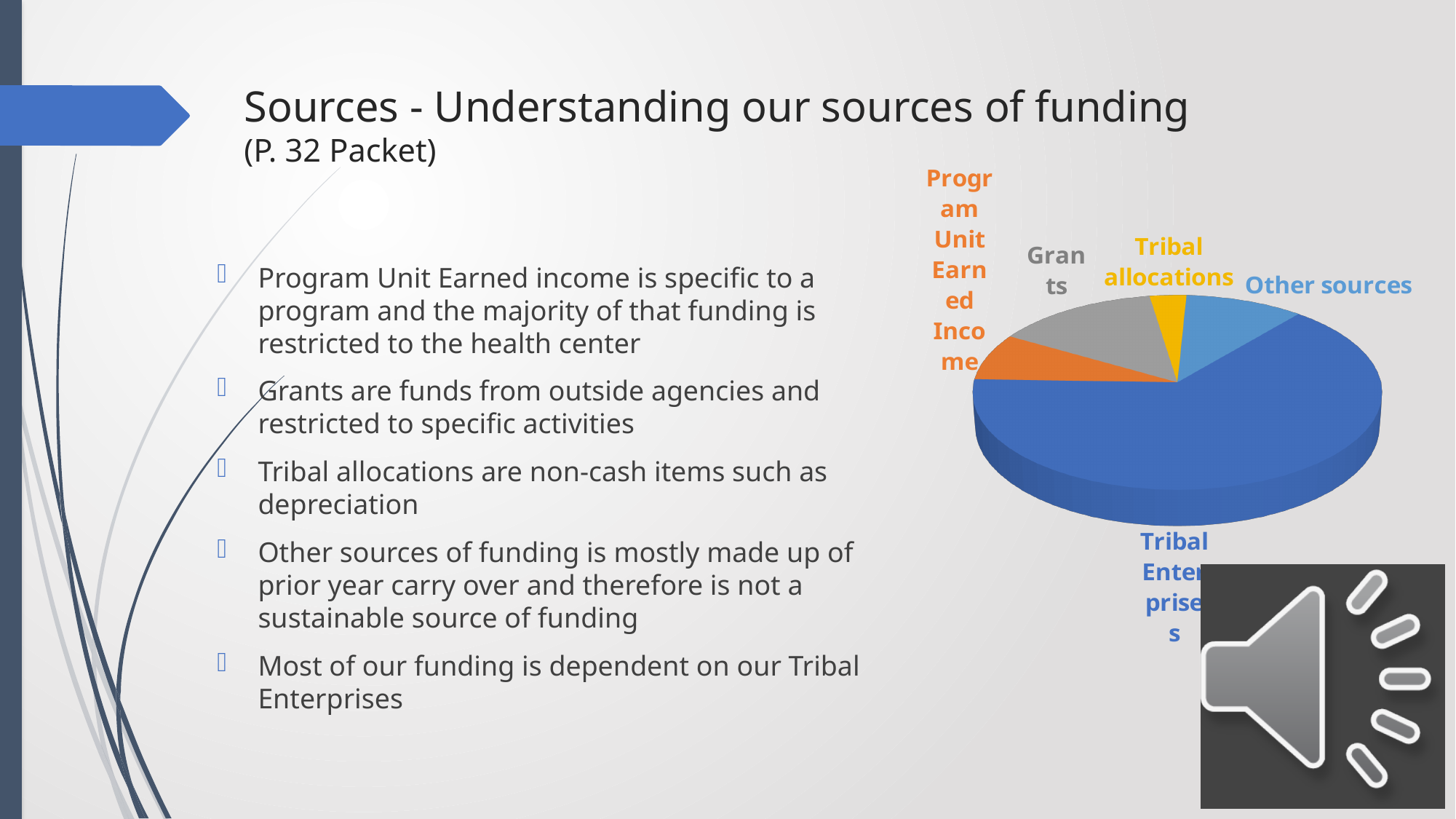
Which funding source has the largest slice of the pie chart? Tribal Enterprises Does the Tribal Enterprises slice make up more or less than half of the pie chart? more What kind of chart is shown on the slide? pie chart Which funding source is shown in yellow in the pie chart? Tribal allocations Which slice is larger in the pie chart, Grants or Program Unit Earned Income? Grants Which slice is larger in the pie chart, Other sources or Tribal allocations? Other sources How many slices does the pie chart have? 5 Which funding source has the smallest slice of the pie chart? Tribal allocations Which slice is larger in the pie chart, Tribal Enterprises or Other sources? Tribal Enterprises What colour is the Tribal Enterprises slice in the pie chart? blue